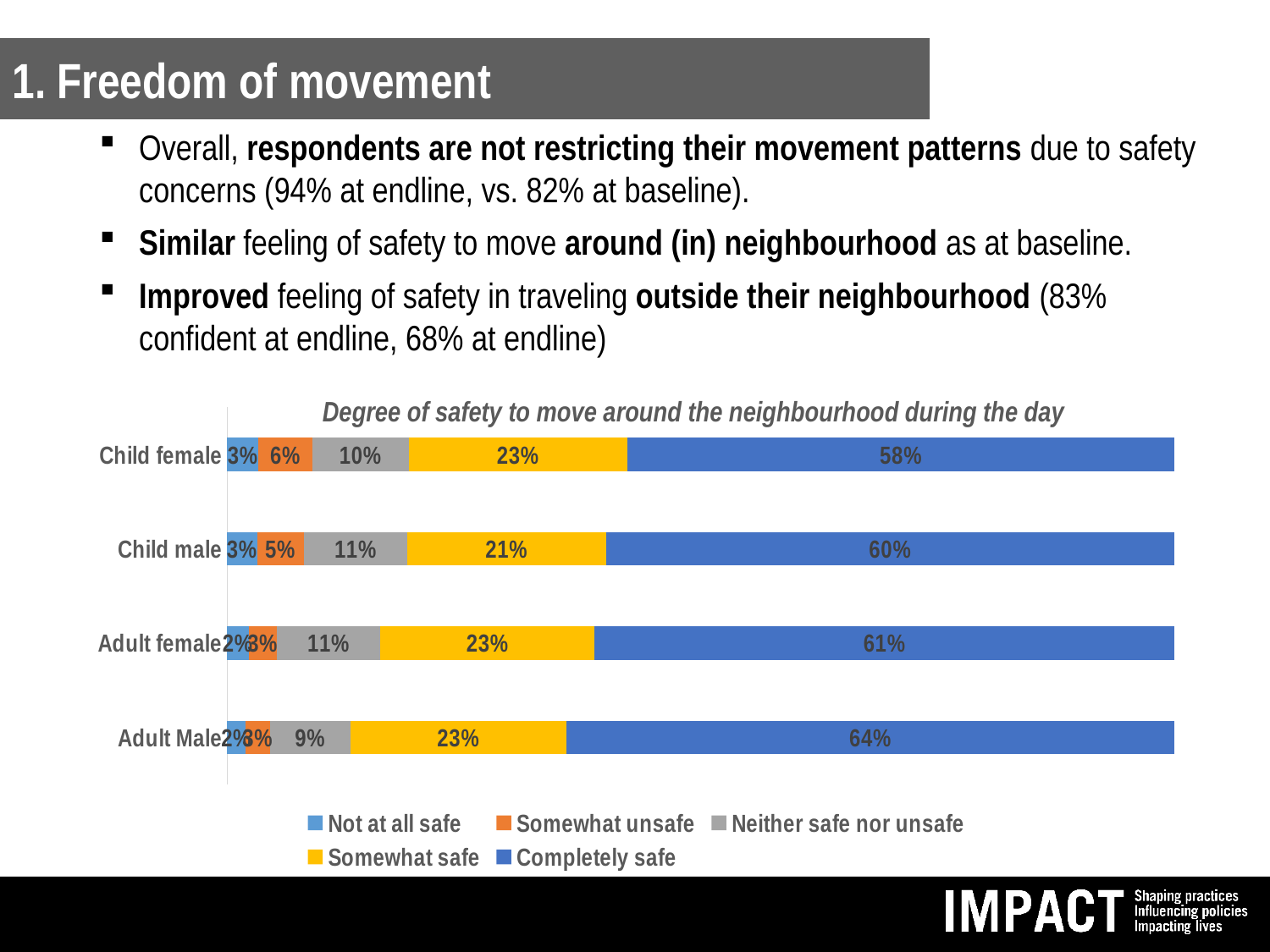
What is the title of the chart? Degree of safety to move around the neighbourhood during the day What is the 'Neither safe nor unsafe' value for Adult Male? 9% What is the 'Somewhat unsafe' value for Child female? 6% What is the 'Completely safe' value for Child female? 58% What is the difference between the 'Completely safe' values for Adult Male and Child female? 6% How many series does the chart legend list? 5 Which category has the highest 'Completely safe' value? Adult Male What is the 'Somewhat safe' value for Child male? 21% Which category has the lowest 'Completely safe' value? Child female What kind of chart is shown on the slide? Stacked bar chart Which is larger, the 'Neither safe nor unsafe' value for Child male or for Adult Male? Child male How many categories are shown on the chart? 4